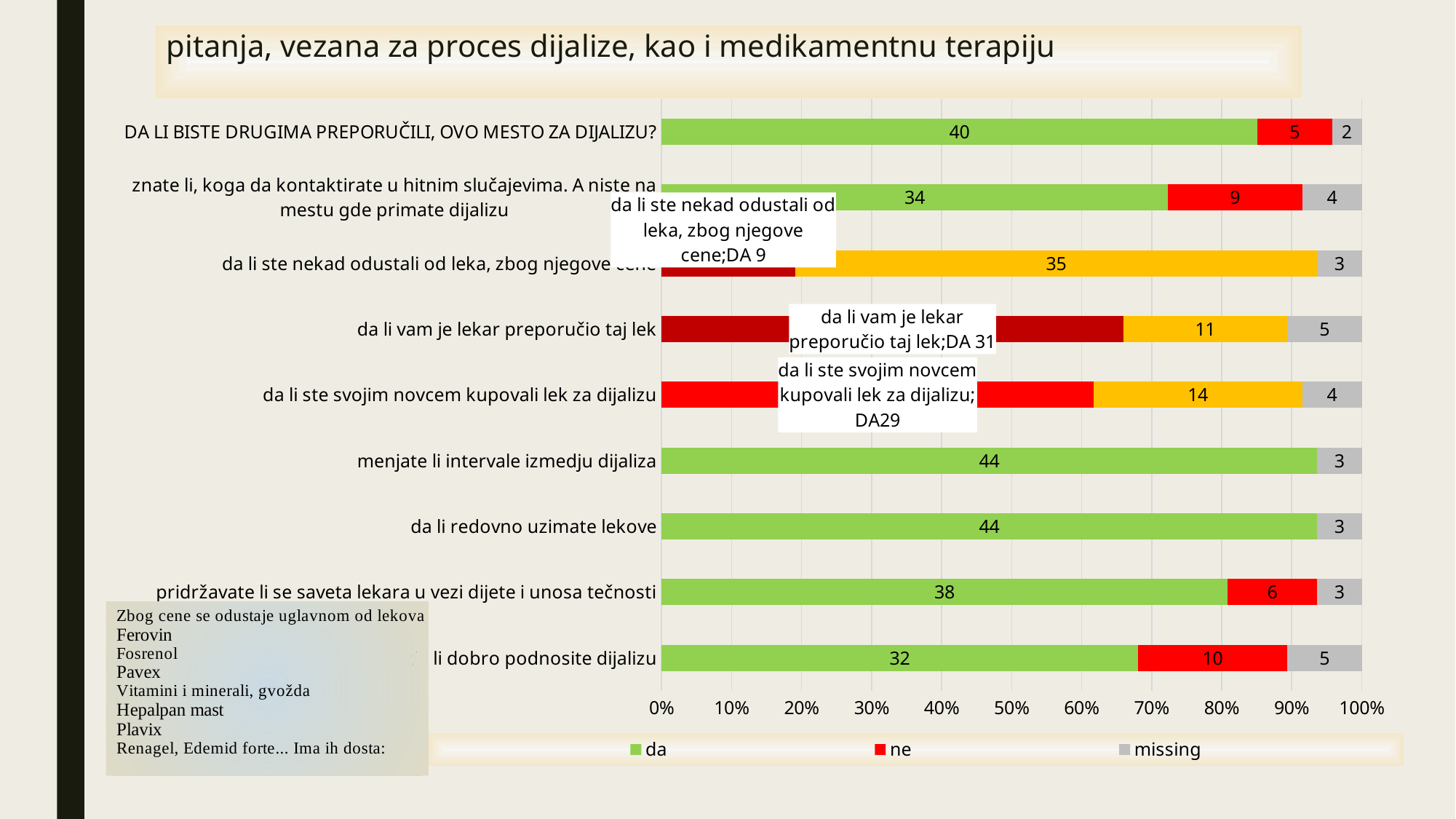
How many question categories are plotted on the chart? 9 What is the 'da' value for 'DA LI BISTE DRUGIMA PREPORUČILI, OVO MESTO ZA DIJALIZU?'? 40 What is the 'missing' value for 'da li vam je lekar preporučio taj lek'? 5 What is the total of the stacked bar for 'pridržavate li se saveta lekara u vezi dijete i unosa tečnosti'? 47 According to the callout label, what is the 'DA' value for 'da li ste svojim novcem kupovali lek za dijalizu'? 29 What is the difference between the 'da' value for 'menjate li intervale izmedju dijaliza' and the 'da' value for 'li dobro podnosite dijalizu'? 12 What kind of chart is shown on the slide? stacked bar chart Which question has the highest 'ne' value? da li ste nekad odustali od leka, zbog njegove cene Which question has the lowest 'missing' value? DA LI BISTE DRUGIMA PREPORUČILI, OVO MESTO ZA DIJALIZU? How many series does the legend list? 3 What is the 'ne' value for 'li dobro podnosite dijalizu'? 10 Which series is shown in green in the legend? da